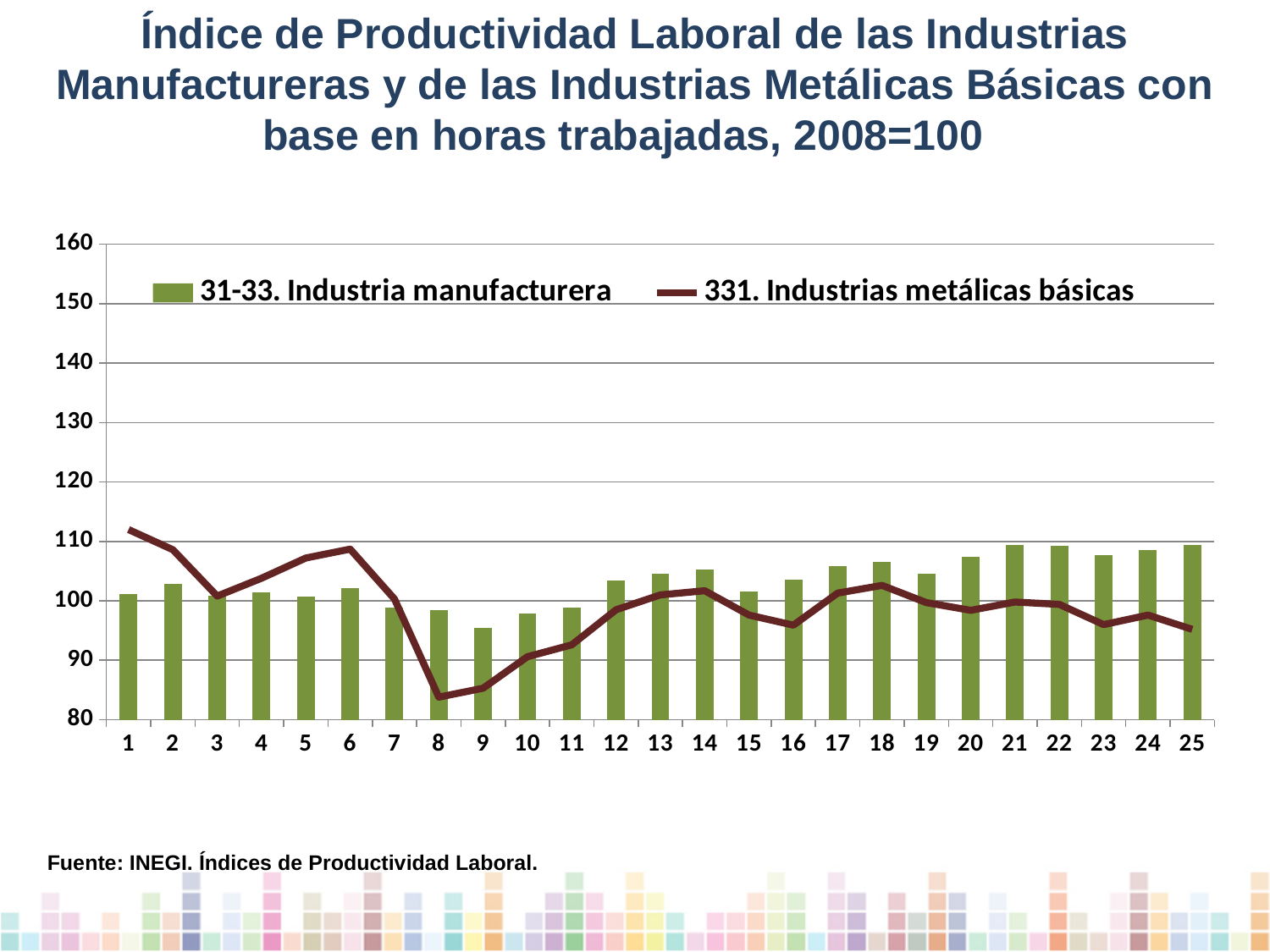
Does the 331. Industrias metálicas básicas line rise or fall from period 6 to period 8? fall In which period is the 331. Industrias metálicas básicas line at its lowest? 8 In which period is the 31-33. Industria manufacturera bar the lowest? 9 Which series is plotted as a line? 331. Industrias metálicas básicas How many series does the legend list? 2 In period 25, which series has the higher value: 31-33. Industria manufacturera or 331. Industrias metálicas básicas? 31-33. Industria manufacturera How many periods are shown on the x axis of the chart? 25 In which period is the 331. Industrias metálicas básicas line at its highest? 1 Is the value of the 331. Industrias metálicas básicas line in period 8 greater or less than 90? less Which series is plotted as bars? 31-33. Industria manufacturera What kind of chart is shown on the slide? A combined bar and line chart Is the value of the 331. Industrias metálicas básicas line in period 1 greater or less than 110? greater